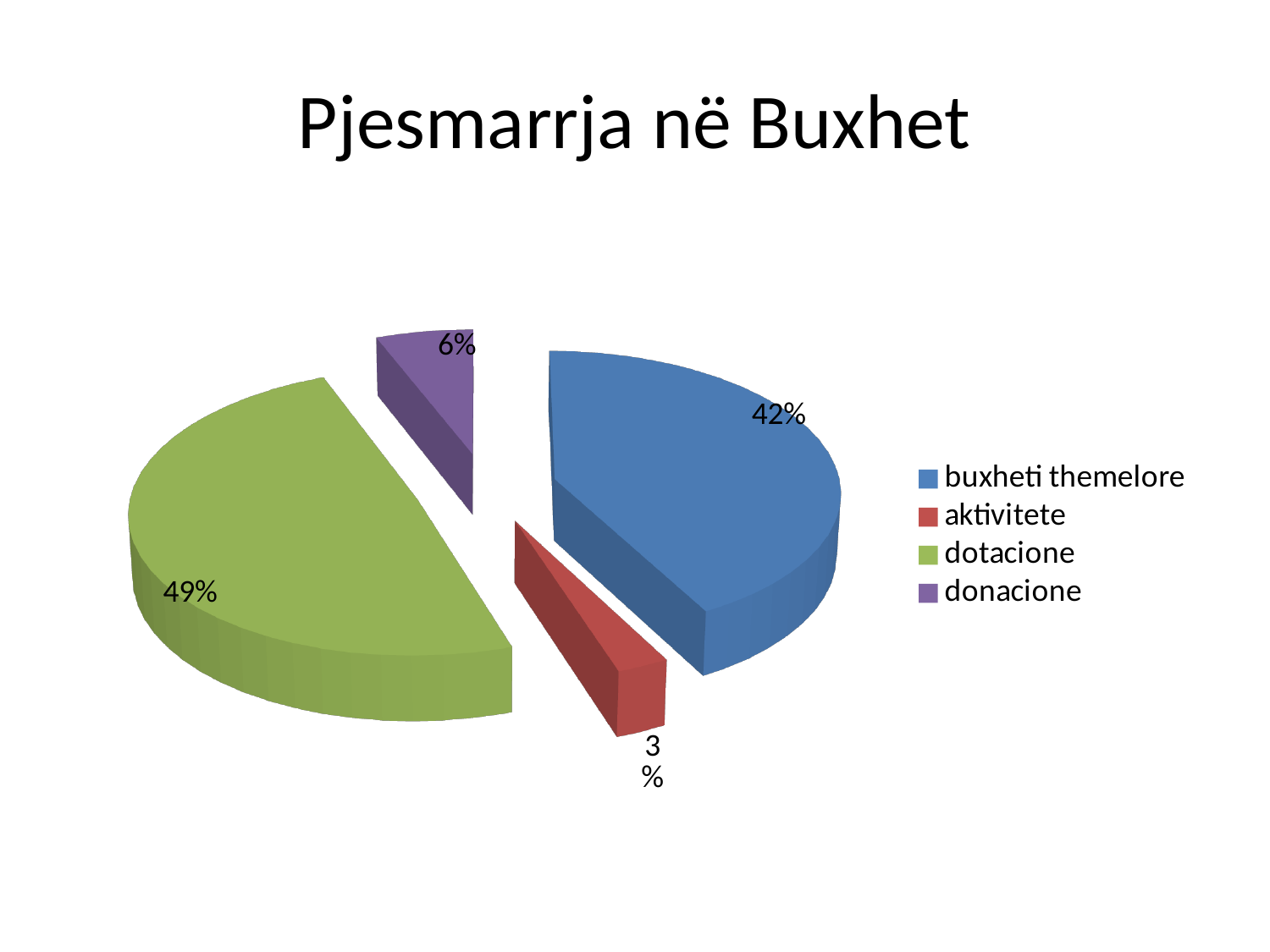
What share of the pie does donacione have? 6% What kind of chart is shown on the slide? pie chart What is the difference in percentage points between dotacione and buxheti themelore? 7 Which is larger, the share for donacione or the share for aktivitete? donacione What is the title of the chart? Pjesmarrja në Buxhet What colour is the slice for dotacione? green What share of the pie does dotacione have? 49% Which category has the smallest slice of the pie? aktivitete Which category has the largest slice of the pie? dotacione What share of the pie does buxheti themelore have? 42% How many categories does the pie chart show? 4